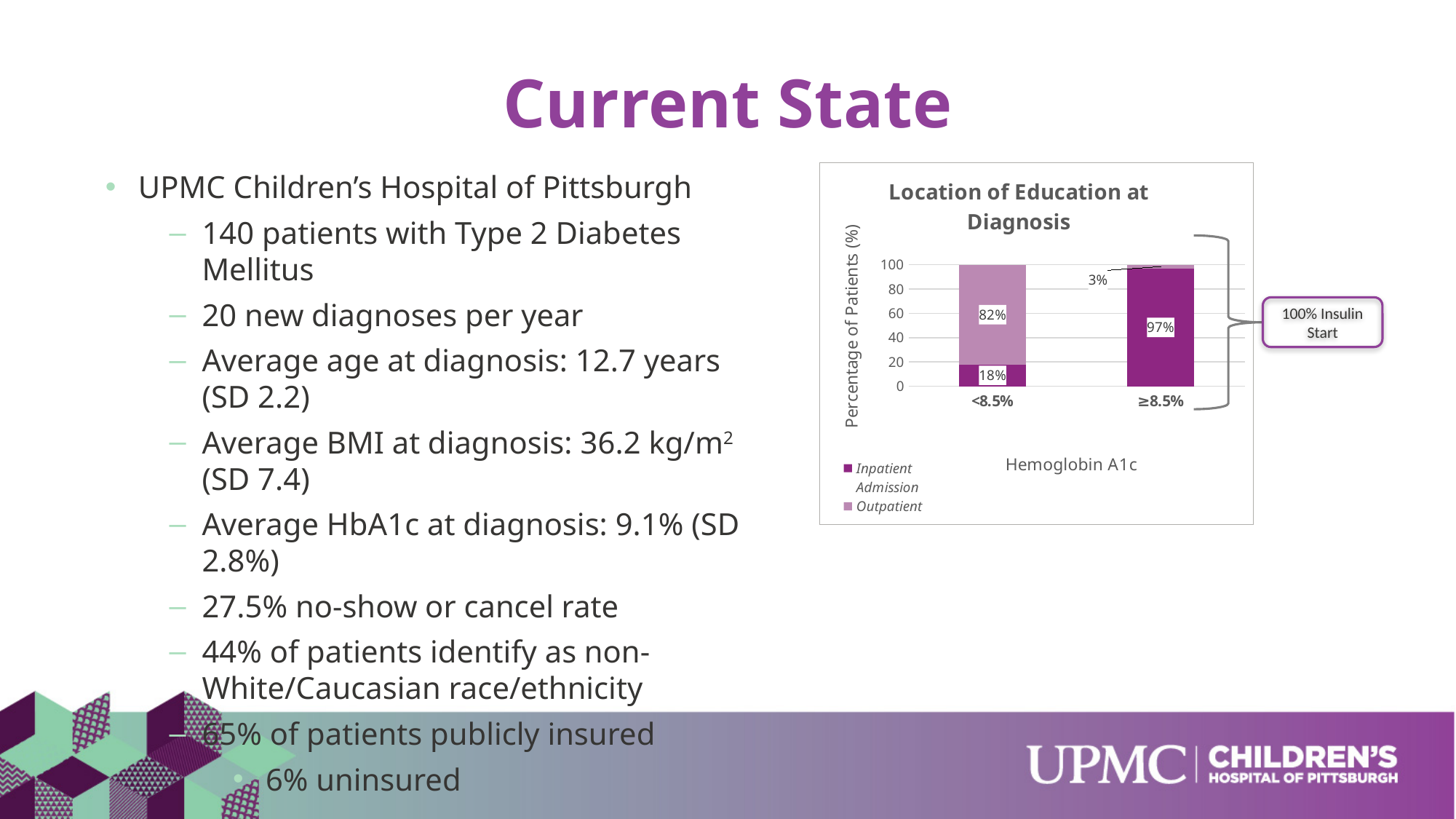
What is the Outpatient value for the <8.5% Hemoglobin A1c group? 82% Which Hemoglobin A1c group has the higher Inpatient Admission percentage? ≥8.5% What type of chart is shown on the slide? Stacked bar chart How many series does the chart legend list? 2 How many Hemoglobin A1c categories are shown on the x axis of the chart? 2 What is the label on the y axis of the chart? Percentage of Patients (%) What is the title of the chart? Location of Education at Diagnosis What is the difference between the Inpatient Admission percentages for the ≥8.5% and <8.5% groups? 79% What is the Inpatient Admission value for the ≥8.5% Hemoglobin A1c group? 97% What is the Outpatient value for the ≥8.5% Hemoglobin A1c group? 3% Is the Outpatient value for the <8.5% group larger or smaller than the Outpatient value for the ≥8.5% group? Larger What is the Inpatient Admission value for the <8.5% Hemoglobin A1c group? 18%